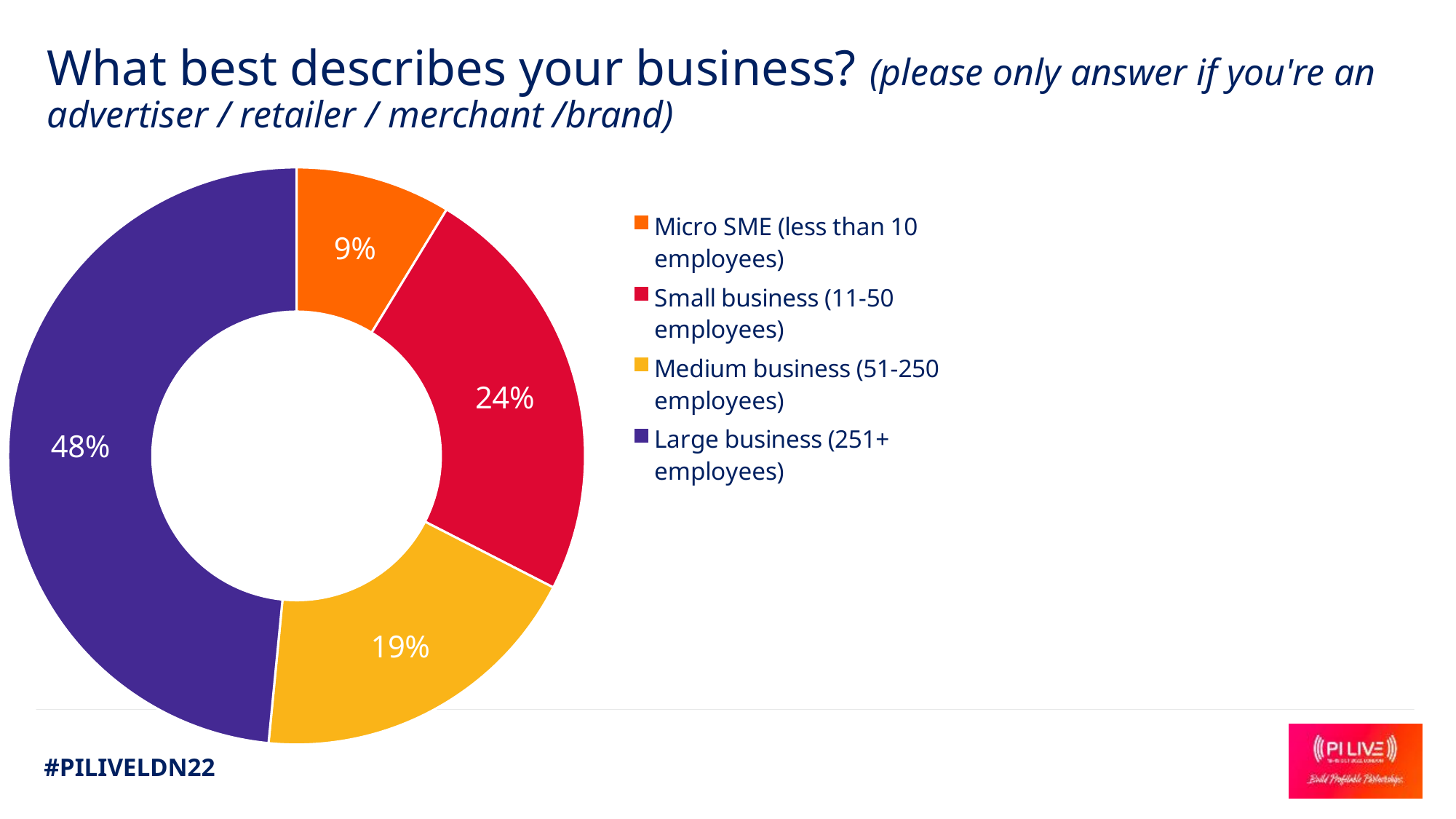
How many categories does the chart show? 4 Which business category has the largest share? Large business (251+ employees) What percentage of respondents are Micro SME (less than 10 employees)? 9% What percentage of respondents are Medium business (51-250 employees)? 19% What colour is the Large business (251+ employees) segment? Purple What is the difference in percentage points between Large business and Small business? 24 What percentage of respondents are Large business (251+ employees)? 48% Which business category has the smallest share? Micro SME (less than 10 employees) What is the difference in percentage points between Small business and Medium business? 5 Which is larger, the share for Medium business or the share for Micro SME? Medium business What kind of chart is shown on the slide? Doughnut (pie) chart What percentage of respondents are Small business (11-50 employees)? 24%